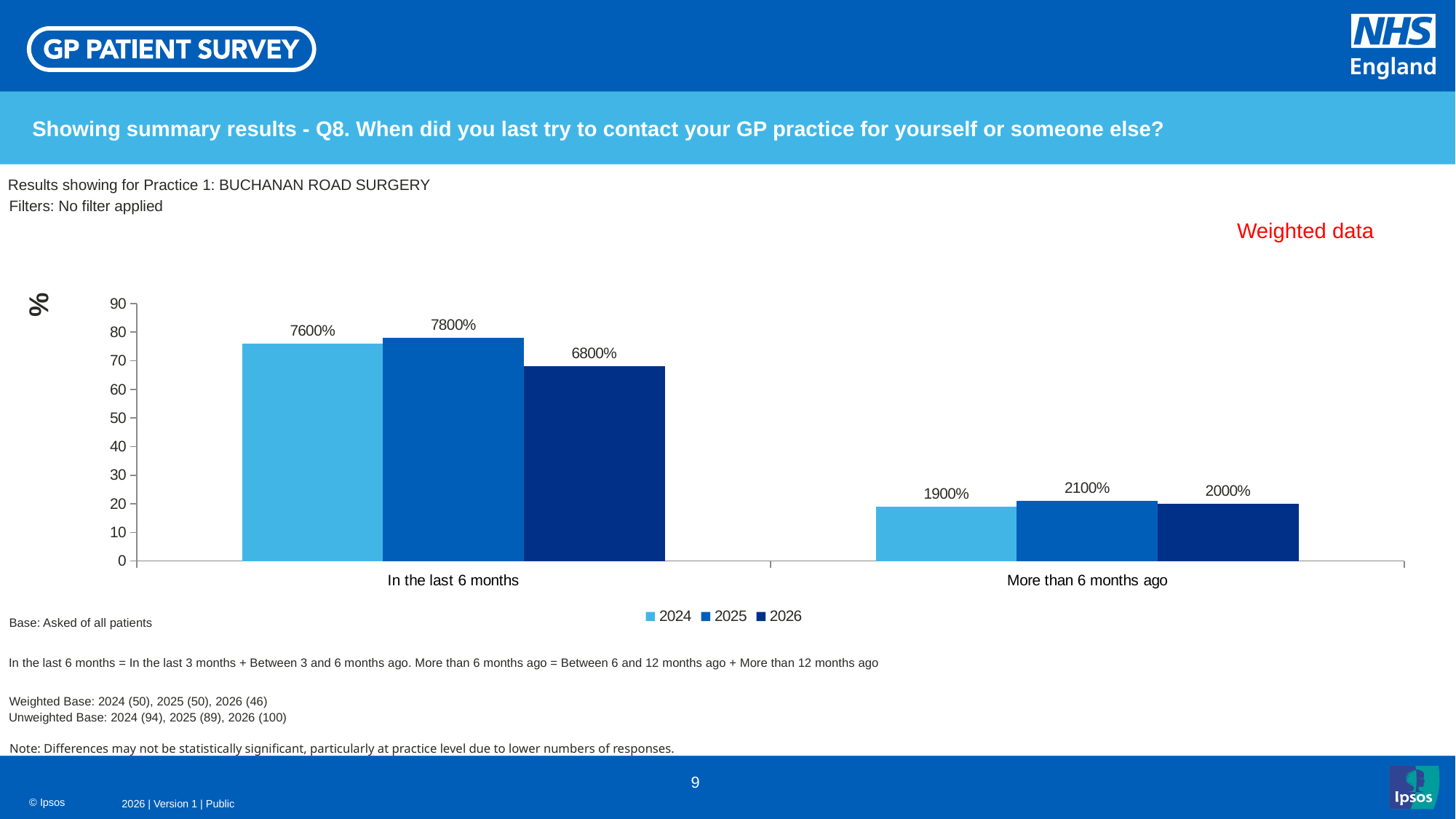
What is the data label for 2024 in the 'More than 6 months ago' category? 1900% What is the data label for 2024 in the 'In the last 6 months' category? 7600% How many categories are shown on the x axis? 2 What is the data label for 2026 in the 'More than 6 months ago' category? 2000% Which is larger in the 'In the last 6 months' category: the 2024 bar or the 2026 bar? 2024 Which year has the lowest bar in the 'More than 6 months ago' category? 2024 What is the data label for 2025 in the 'In the last 6 months' category? 7800% What are the legend entries of the chart? 2024, 2025, 2026 What kind of chart is shown on the slide? bar chart Is the 2026 bar for 'In the last 6 months' greater or less than 70 on the axis? less Which year has the highest bar in the 'In the last 6 months' category? 2025 How many series does the legend list? 3